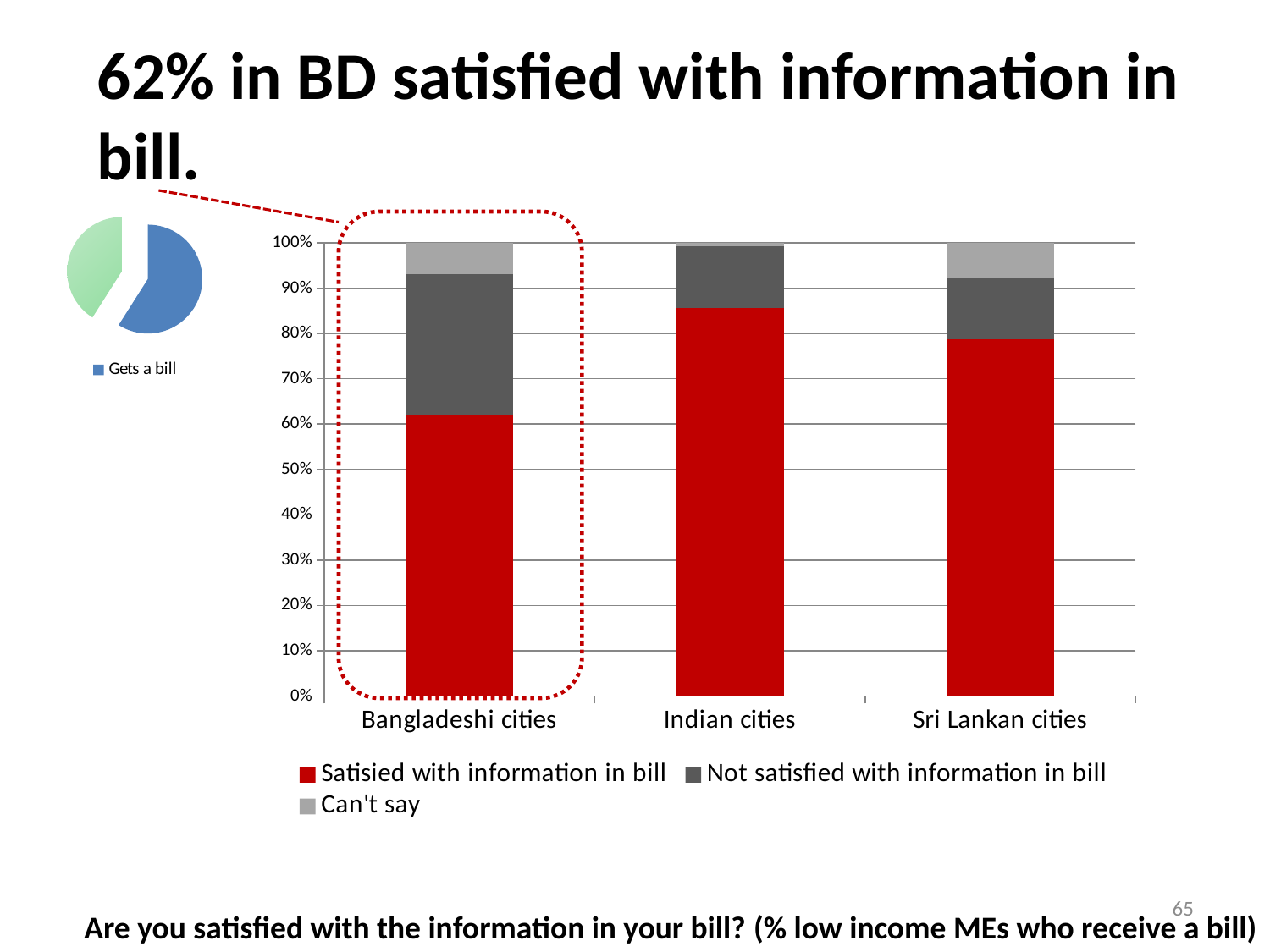
In the large stacked bar chart, is the satisfied share for Indian cities greater or less than 80%? greater What type of chart is the small chart at the top left of the slide? Pie chart In the large stacked bar chart, which city group has the largest 'Not satisfied with information in bill' segment? Bangladeshi cities In the large stacked bar chart, is the satisfied share larger for Indian cities or Sri Lankan cities? Indian cities How many city groups are shown on the x axis of the large stacked bar chart? 3 In the large stacked bar chart, which city group has the smallest 'Can't say' segment? Indian cities What type of chart is the large chart in the centre of the slide? Stacked bar chart In the large stacked bar chart, which city group has the lowest share satisfied with information in the bill? Bangladeshi cities In the large stacked bar chart, is the satisfied share for Sri Lankan cities greater or less than 80%? less In the large stacked bar chart, which city group has the highest share satisfied with information in the bill? Indian cities In the large stacked bar chart, what percentage of respondents in Bangladeshi cities are satisfied with the information in their bill? 62% How many series does the legend of the large stacked bar chart list? 3